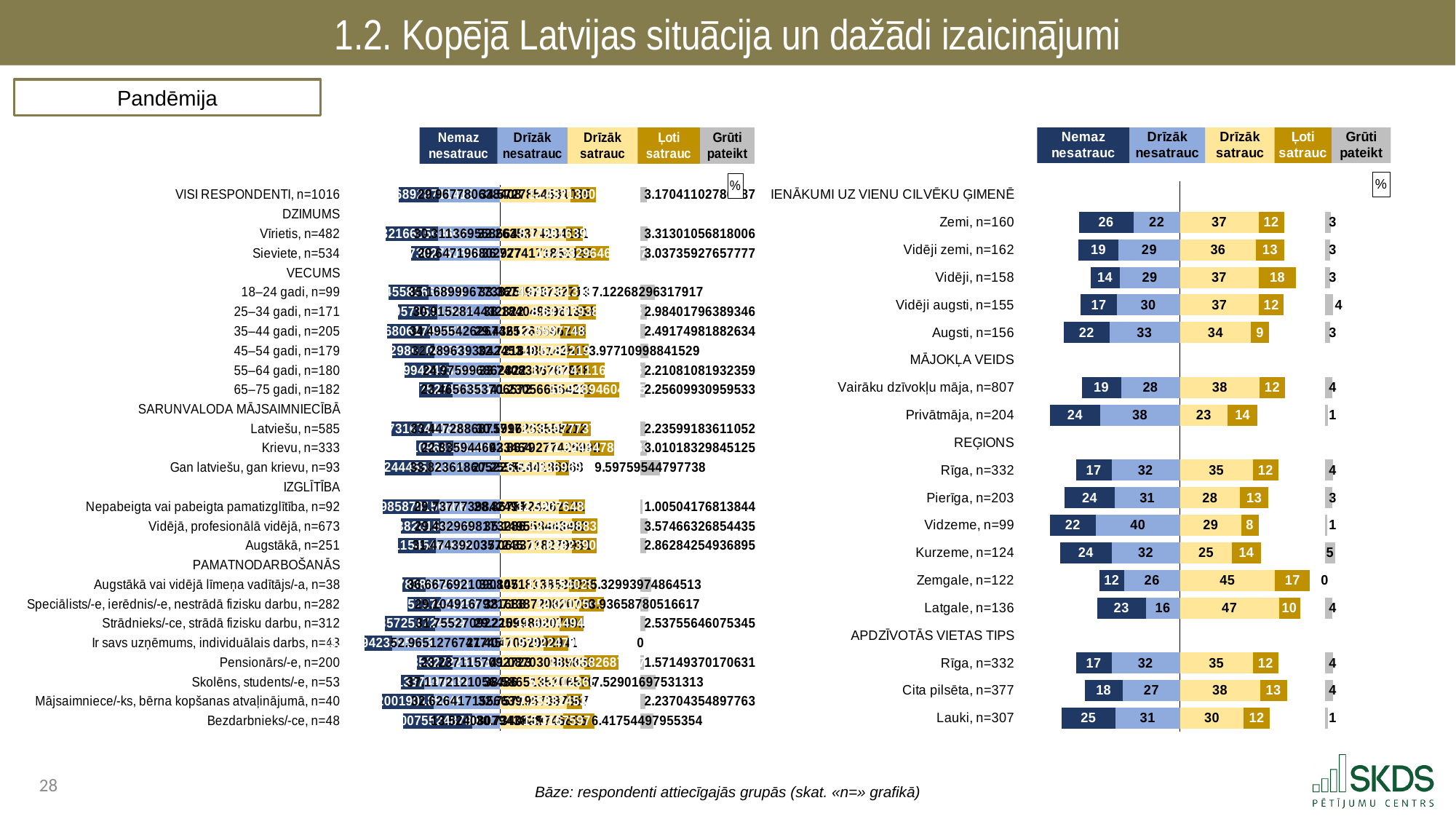
What type of chart is the right chart? Stacked bar chart In the right chart, what is the difference between the 'Drīzāk satrauc' values for 'Latgale, n=136' and 'Kurzeme, n=124'? 22 In the right chart, what is the 'Nemaz nesatrauc' value for 'Privātmāja, n=204'? 24 In the right chart, what percentage of respondents with 'Zemi' income answered 'Drīzāk satrauc'? 37 In the right chart, what is the 'Ļoti satrauc' value for 'Vidzeme, n=99'? 8 In the right chart, which region has the lowest 'Nemaz nesatrauc' value? Zemgale, n=122 How many series does the legend of the right chart list? 5 How many stacked bars are plotted in the right chart? 16 In the right chart, what is the total of the stacked bar for 'Zemgale, n=122'? 100 In the right chart, which legend entry is shown in dark gold colour? Ļoti satrauc In the right chart, which has a larger 'Drīzāk nesatrauc' value: 'Vidzeme, n=99' or 'Latgale, n=136'? Vidzeme, n=99 In the right chart, which income group has the highest 'Ļoti satrauc' value? Vidēji, n=158